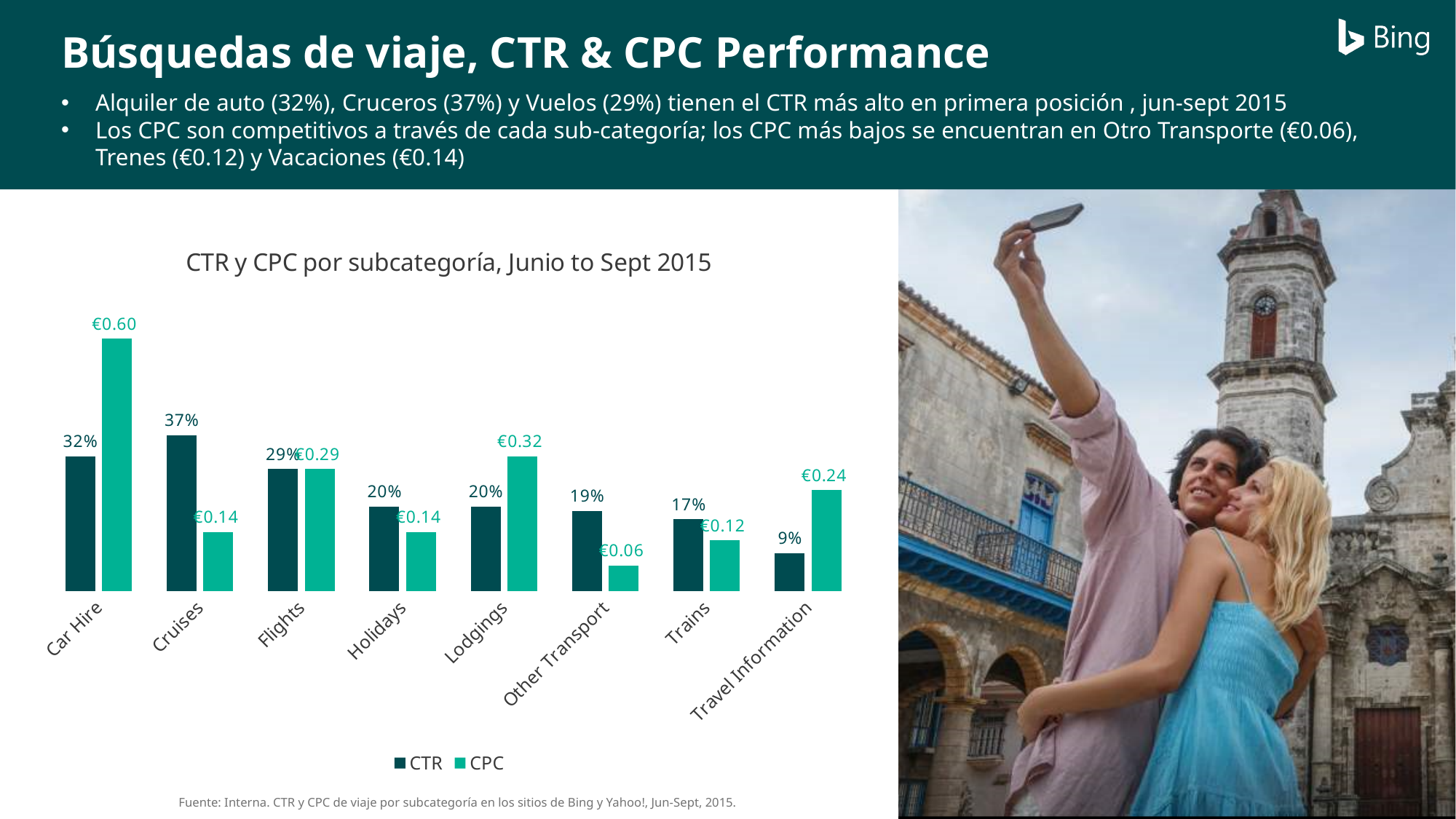
What is the difference in CTR between Cruises and Trains? 20% Which subcategory has the lowest CPC? Other Transport Which has a higher CPC, Lodgings or Flights? Lodgings What type of chart is shown on the slide? Bar chart What is the CTR for Cruises? 37% How many subcategories are shown on the x axis? 8 How many series does the legend list? 2 What is the CPC for Other Transport? €0.06 Which subcategory has the highest CTR? Cruises What is the CTR for Travel Information? 9% What is the CPC for Car Hire? €0.60 Which subcategory has the highest CPC? Car Hire